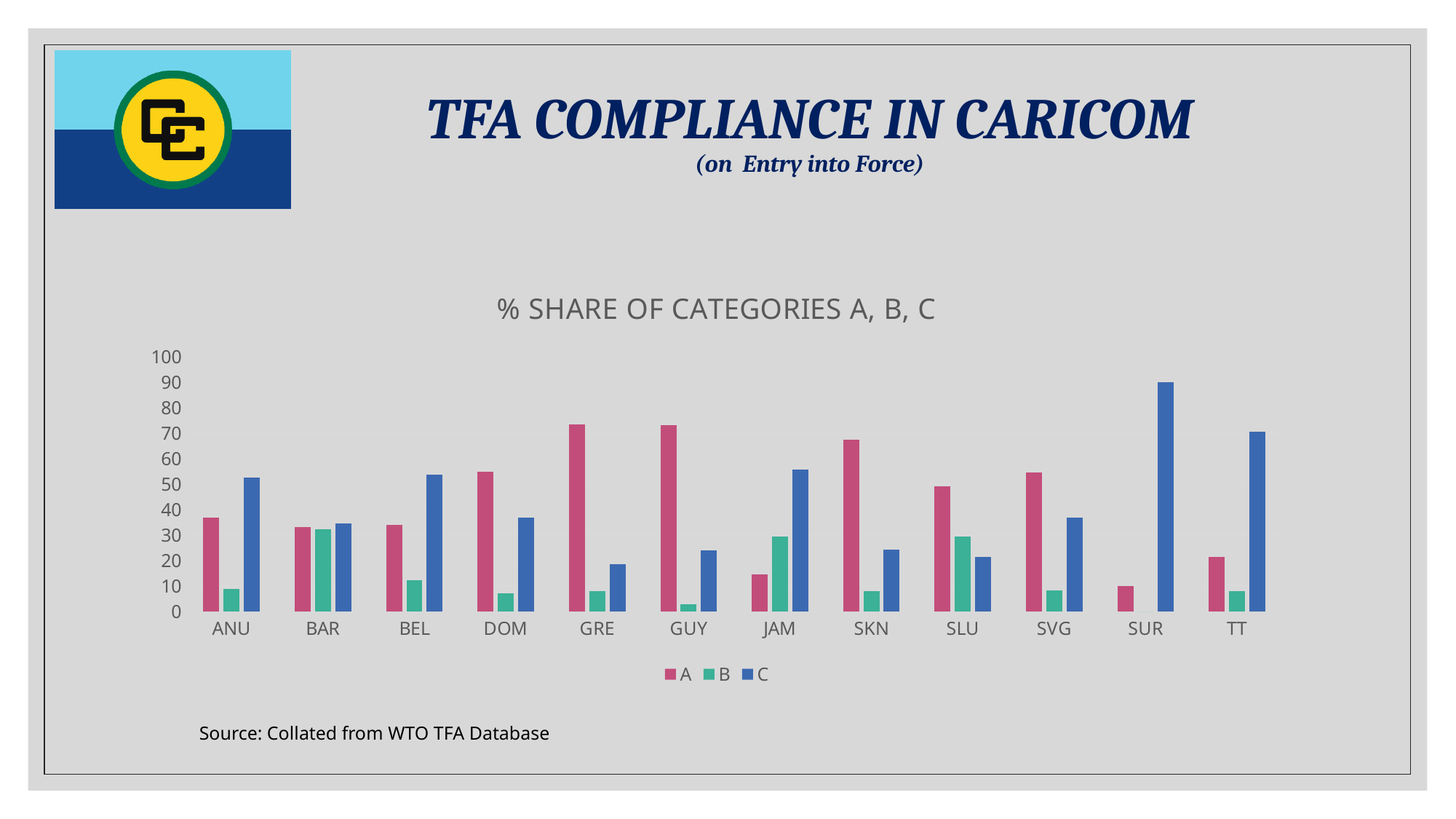
Is the value for series C for TT greater or less than 60? greater For GRE, which series has the larger value, A or C? A Which country has the lowest value for series A? SUR What kind of chart is shown on the slide? Bar chart How many series does the chart's legend list? 3 Which country has the highest value for series C? SUR Is the value for series A for SKN greater or less than 60? greater What is the title of the chart? % SHARE OF CATEGORIES A, B, C How many countries (categories) are shown on the x axis of the chart? 12 Is the value for series C for SUR greater or less than 80? greater For JAM, which series has the larger value, A or B? B